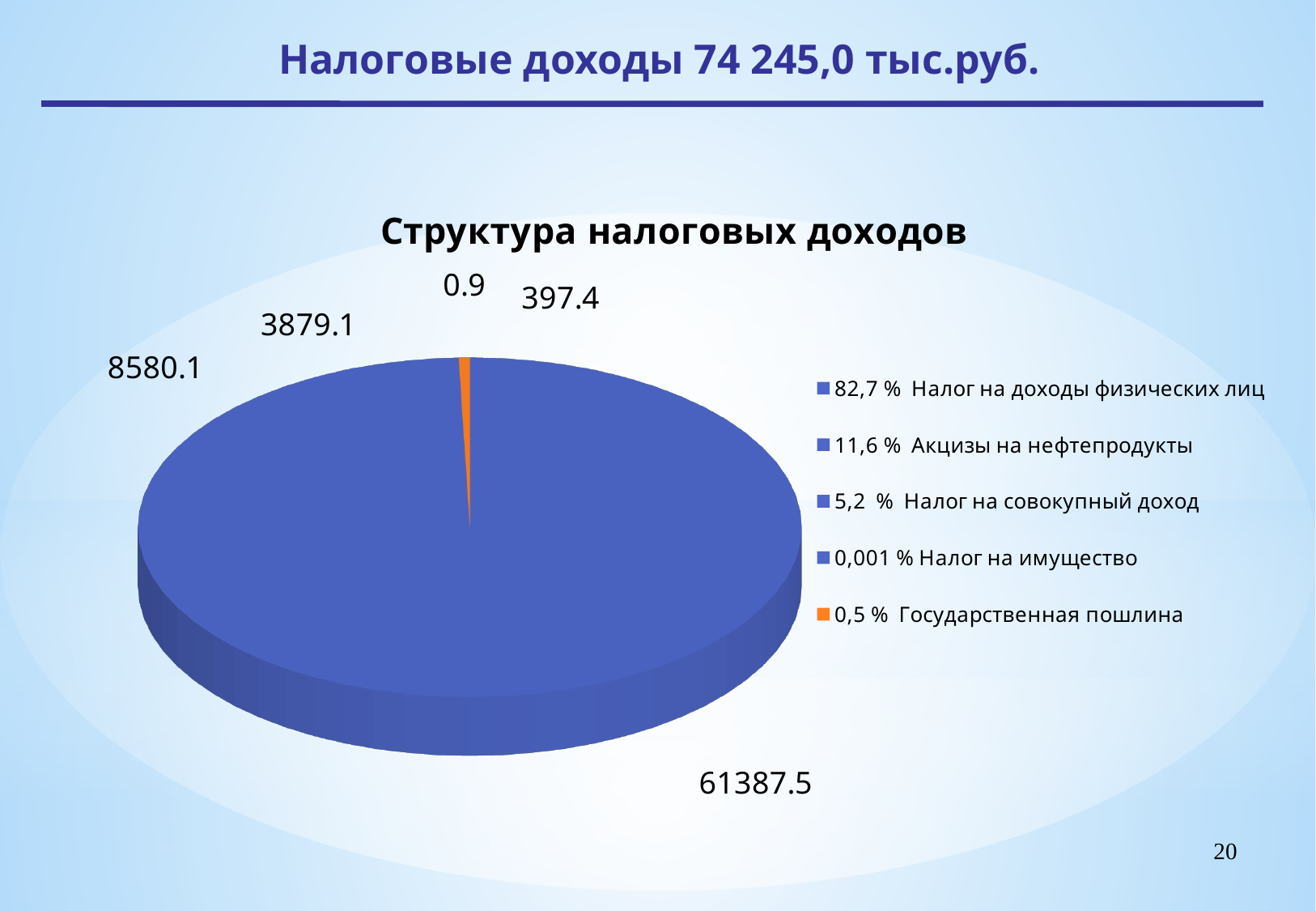
What is the largest value shown on the pie chart? 61387.5 What is the smallest value shown on the pie chart? 0.9 What value is labelled for Государственная пошлина? 397.4 What share of the pie does Налог на доходы физических лиц represent, according to the legend? 82,7 % How many categories does the legend of the chart list? 5 What is the title of the chart? Структура налоговых доходов What value is labelled for Акцизы на нефтепродукты? 8580.1 Which legend entry is shown in orange? 0,5 % Государственная пошлина What value is labelled for Налог на доходы физических лиц? 61387.5 What kind of chart is shown on the slide? pie chart What share of the pie does Налог на совокупный доход represent, according to the legend? 5,2 % Which is larger: the value 8580.1 or the value 3879.1? 8580.1